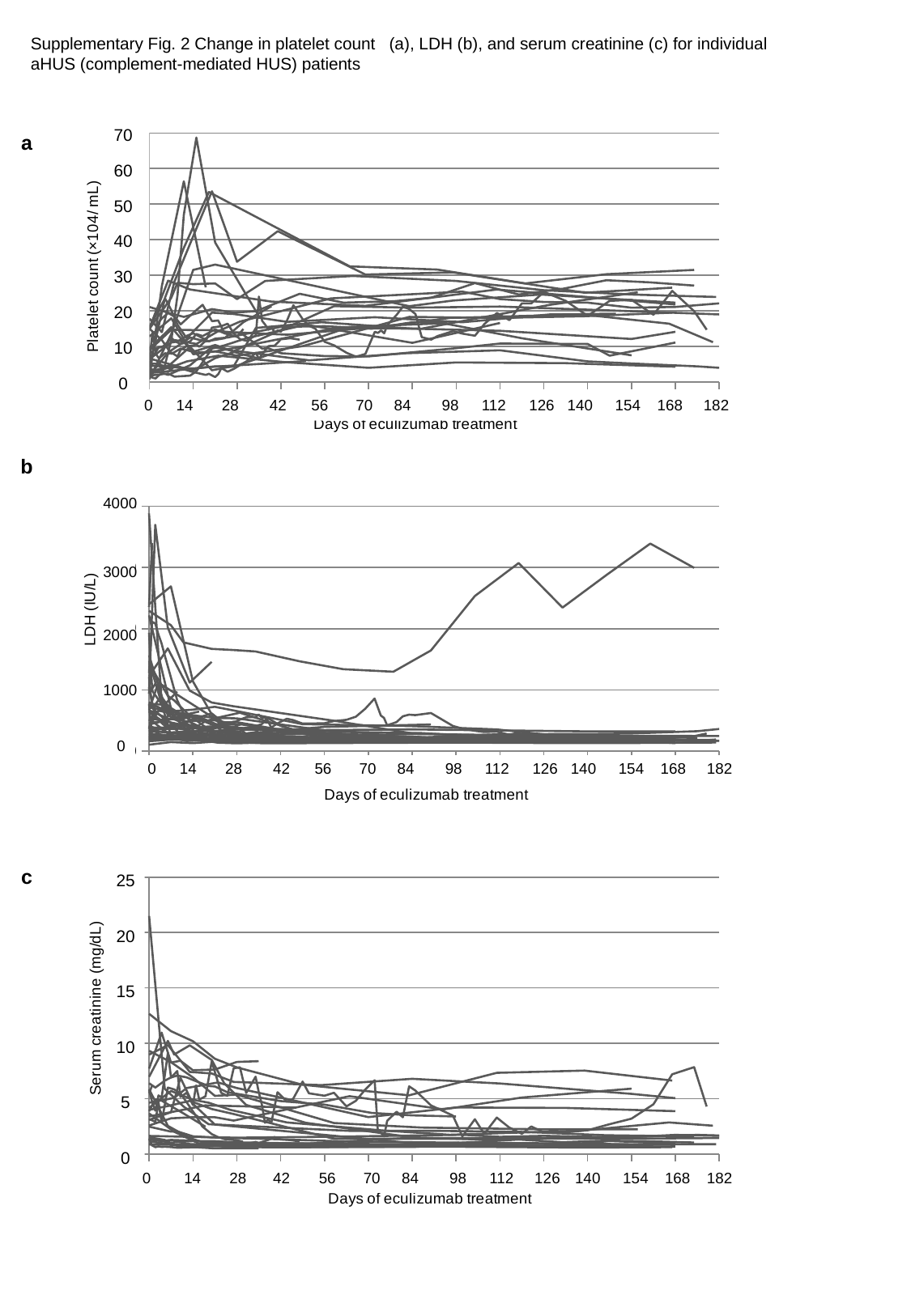
In chart a, what is the last day value shown on the x axis? 182 In chart c, is the highest serum creatinine value at day 0 greater or less than 15? greater How many charts are shown on the slide? 3 In chart a, what is the highest value shown on the y axis? 70 What kind of chart is chart a (Platelet count)? line chart In chart b, what is the label of the y axis? LDH (IU/L) In chart c, what is the highest value shown on the y axis? 25 In chart a, is the highest platelet count reached by any patient greater or less than 60? greater In chart b, what is the highest value shown on the y axis? 4000 In chart b, do the LDH values for most patients rise or fall over the first 28 days of treatment? fall In chart c, what is the label of the y axis? Serum creatinine (mg/dL) In chart b, is the peak LDH value of the patient whose LDH rises again after day 98 greater or less than 3000? greater